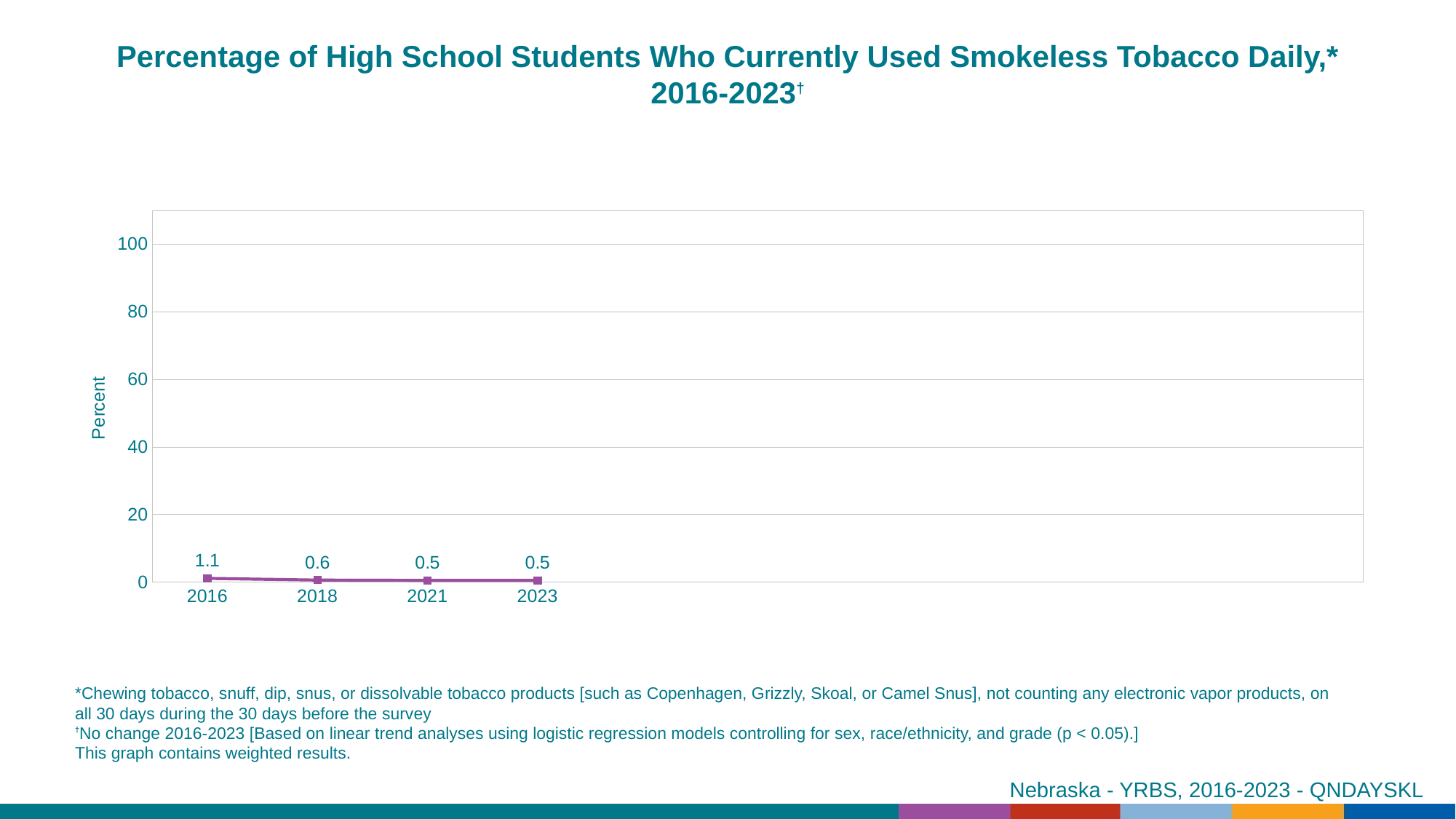
What is the value for 2023? 0.5 Which is larger, the value for 2016 or the value for 2018? 2016 What kind of chart is shown on the slide? line chart How many years are plotted on the chart? 4 What is the difference between the values for 2016 and 2018? 0.5 Is the value for 2016 greater or less than 20? less Do the values rise or fall from 2016 to 2018? fall What is the difference between the values for 2016 and 2023? 0.6 Which year has the highest value? 2016 What is the value for 2016? 1.1 What is the value for 2021? 0.5 What is the value for 2018? 0.6